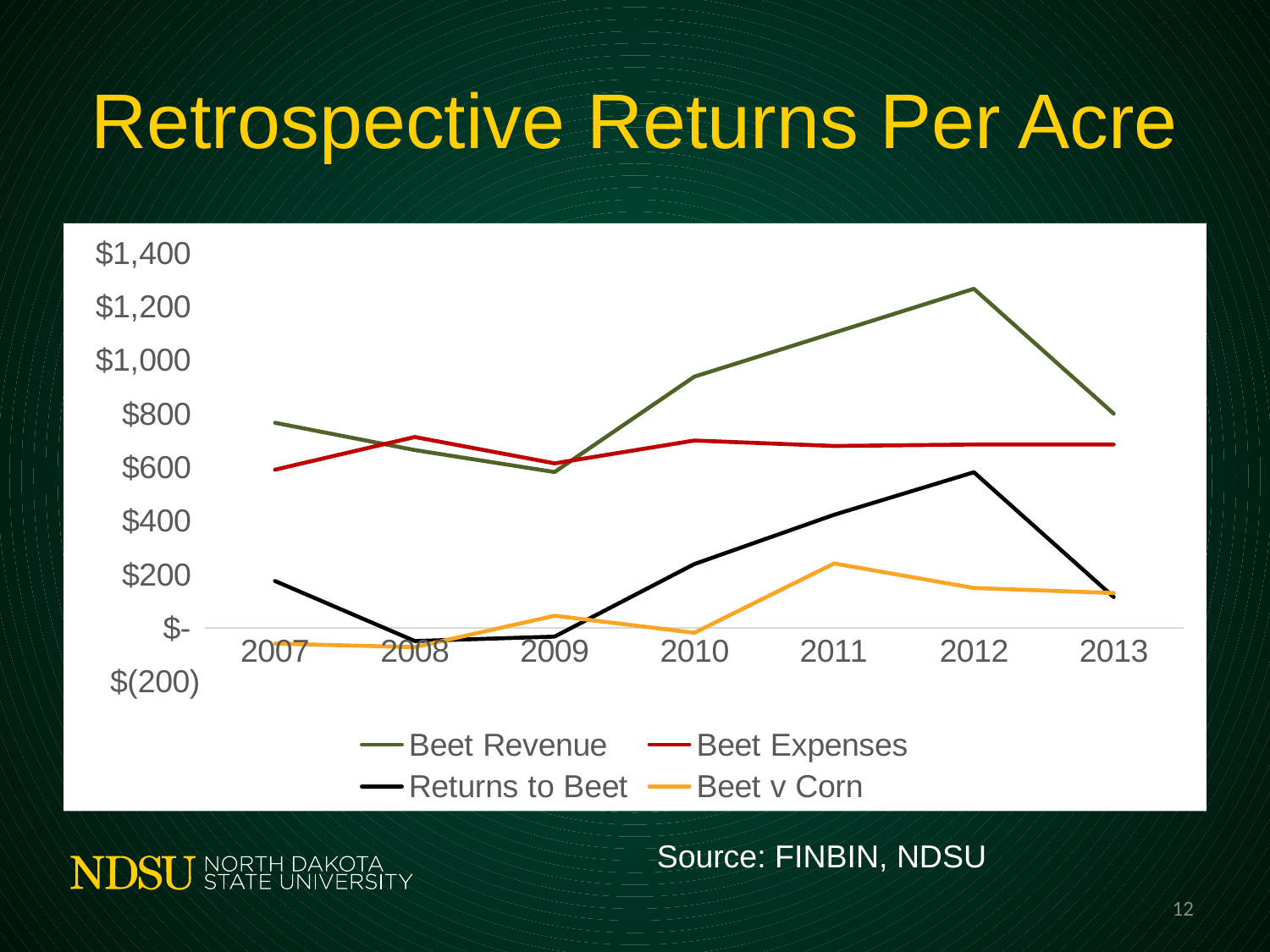
In which year is Beet v Corn highest? 2011 Which is larger in 2008, Beet Revenue or Beet Expenses? Beet Expenses In which year is Beet Revenue lowest? 2009 Is the value for Returns to Beet in 2008 greater or less than $-? less Does Beet Revenue rise or fall from 2009 to 2012? rise Is the value for Beet Revenue in 2012 greater or less than $1,200? greater How many years are plotted along the x axis? 7 What kind of chart is shown on the slide? line chart What is the title of the slide's chart? Retrospective Returns Per Acre Is the value for Beet Expenses in 2013 greater or less than $800? less How many series does the legend list? 4 In which year is Beet Revenue highest? 2012